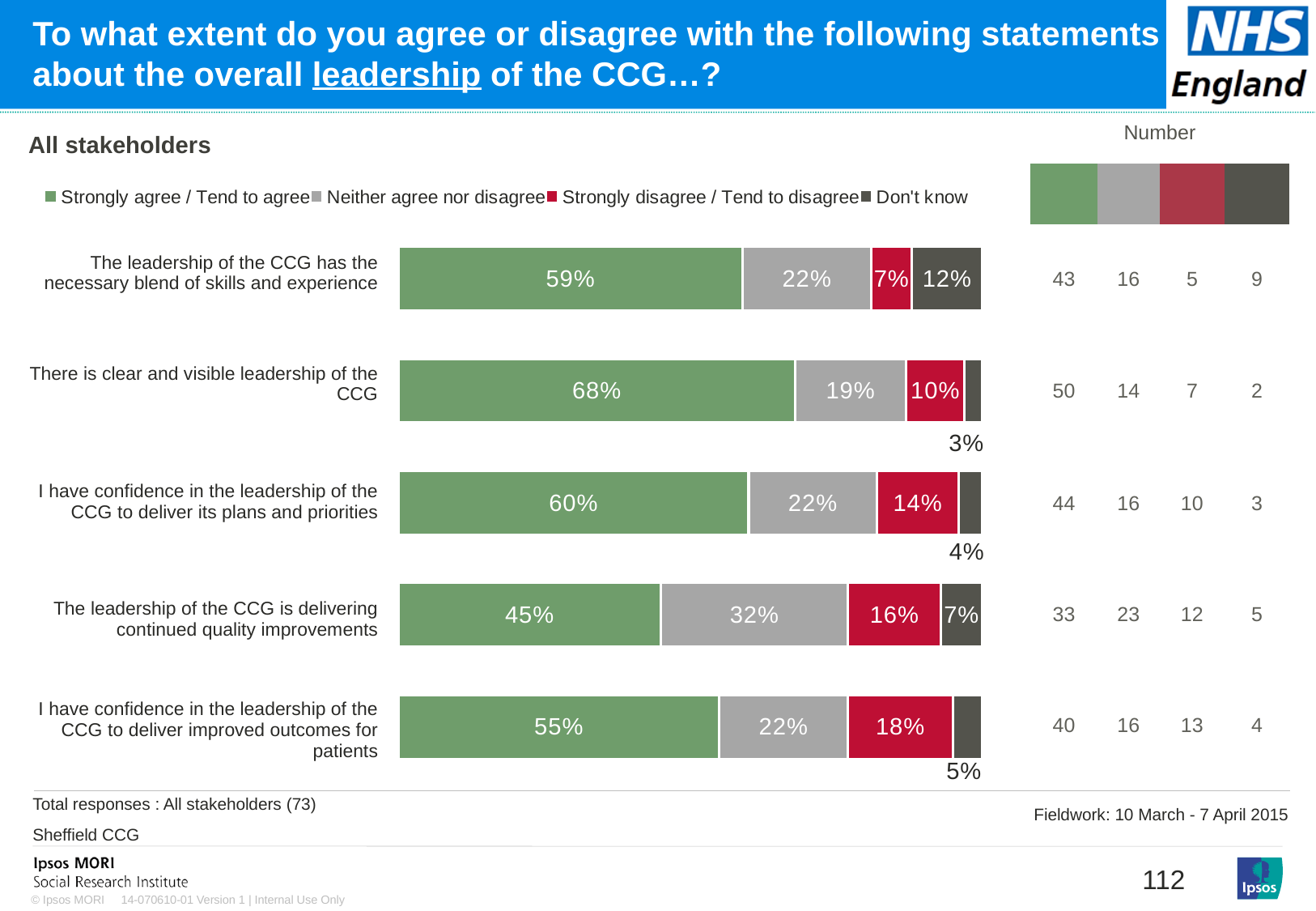
Which colour represents 'Strongly disagree / Tend to disagree' in the chart? Red Which has a larger 'Strongly disagree / Tend to disagree' percentage: 'I have confidence in the leadership of the CCG to deliver its plans and priorities' or 'The leadership of the CCG is delivering continued quality improvements'? The leadership of the CCG is delivering continued quality improvements What percentage of stakeholders strongly disagree or tend to disagree that they have confidence in the leadership of the CCG to deliver improved outcomes for patients? 18% What percentage of stakeholders strongly agree or tend to agree that there is clear and visible leadership of the CCG? 68% What percentage of stakeholders neither agree nor disagree that the leadership of the CCG is delivering continued quality improvements? 32% How many series does the legend list? 4 What is the difference in the 'Strongly agree / Tend to agree' percentage between 'There is clear and visible leadership of the CCG' and 'The leadership of the CCG is delivering continued quality improvements'? 23 percentage points Which statement has the highest percentage of stakeholders who strongly agree or tend to agree? There is clear and visible leadership of the CCG What kind of chart is shown on the slide? Stacked bar chart How many statements are shown in the chart? 5 What percentage answered 'Don't know' for the statement that the leadership of the CCG has the necessary blend of skills and experience? 12% Which statement has the lowest percentage of stakeholders who strongly agree or tend to agree? The leadership of the CCG is delivering continued quality improvements